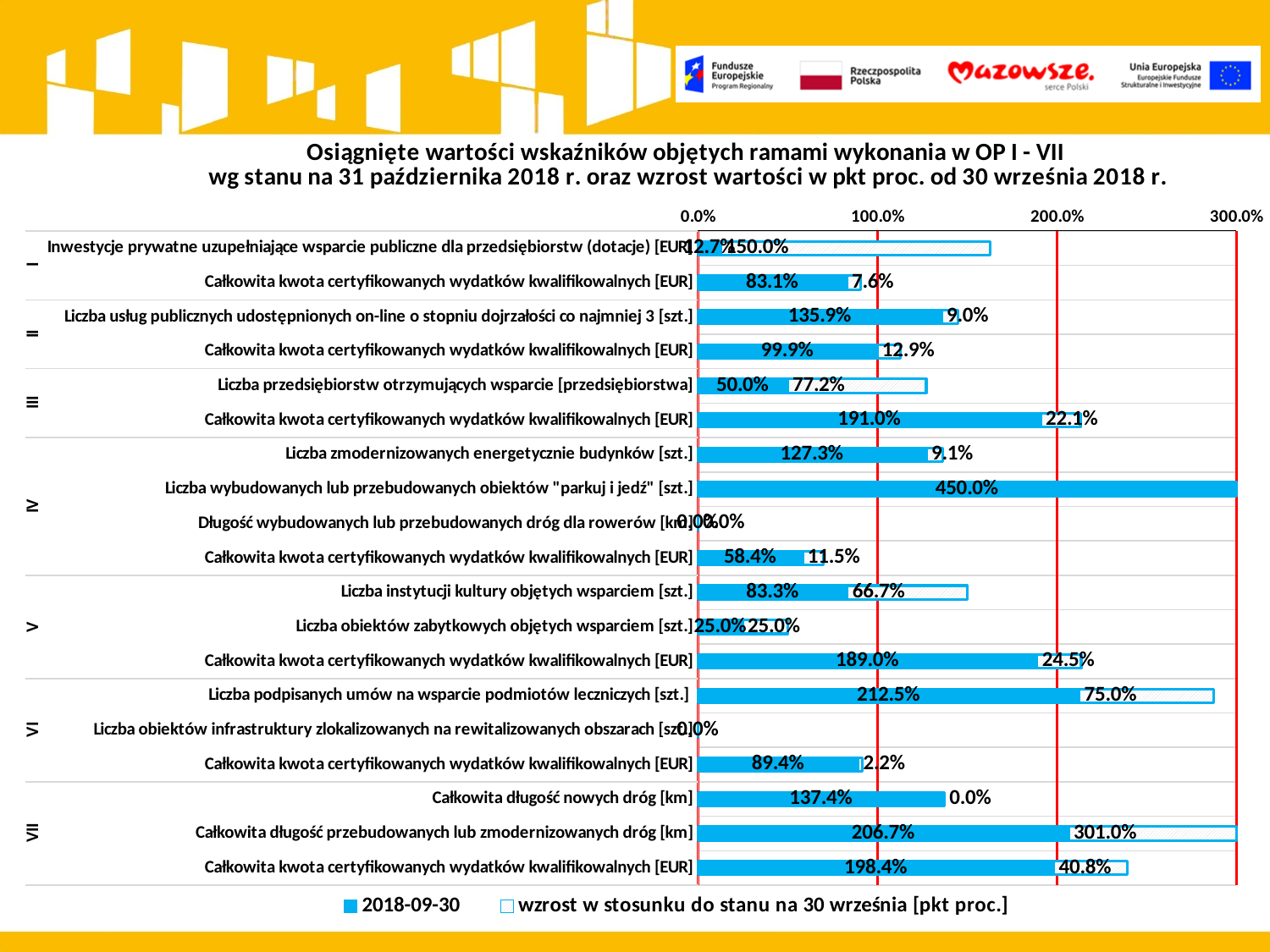
What is the 2018-09-30 value for 'Całkowita kwota certyfikowanych wydatków kwalifikowalnych [EUR]' in OP III? 191.0% How many indicator categories are plotted on the chart? 19 What kind of chart is shown on the slide? bar chart What is the 2018-09-30 value for 'Liczba podpisanych umów na wsparcie podmiotów leczniczych [szt.]'? 212.5% What is the growth value (wzrost w stosunku do stanu na 30 września) for 'Całkowita długość przebudowanych lub zmodernizowanych dróg [km]'? 301.0% Which indicator has the highest 2018-09-30 value? Liczba wybudowanych lub przebudowanych obiektów "parkuj i jedź" [szt.] What is the total of the stacked bar for 'Liczba instytucji kultury objętych wsparciem [szt.]'? 150.0% How many series does the legend list? 2 Which has a larger 2018-09-30 value: 'Całkowita kwota certyfikowanych wydatków kwalifikowalnych [EUR]' in OP III or in OP IV? OP III What is the difference between the 2018-09-30 values for 'Liczba usług publicznych udostępnionych on-line o stopniu dojrzałości co najmniej 3 [szt.]' and 'Liczba zmodernizowanych energetycznie budynków [szt.]'? 8.6% What is the 2018-09-30 value for 'Liczba wybudowanych lub przebudowanych obiektów "parkuj i jedź" [szt.]'? 450.0% Which indicator has the highest growth value (wzrost w stosunku do stanu na 30 września)? Całkowita długość przebudowanych lub zmodernizowanych dróg [km]